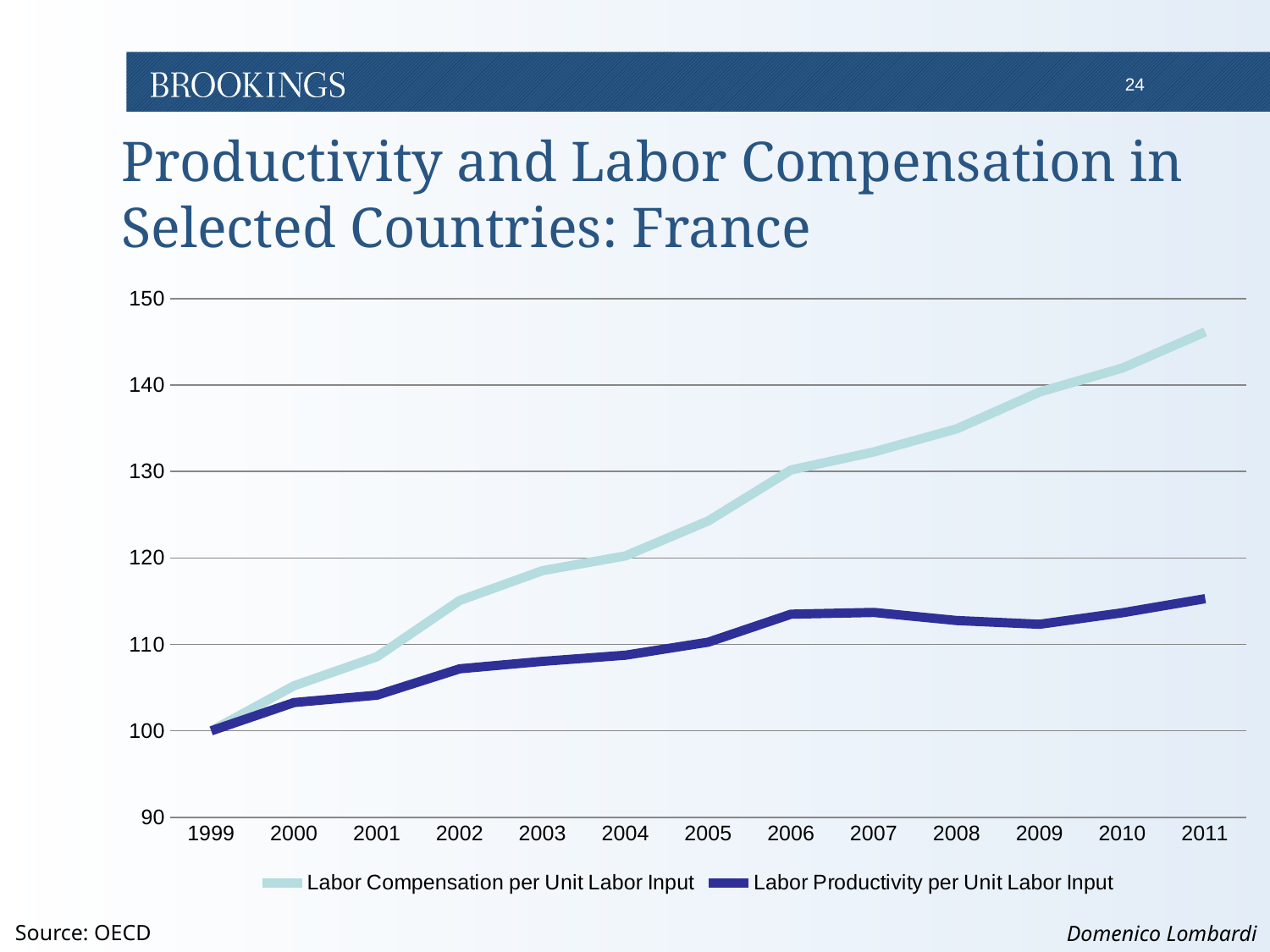
What is the value of Labor Productivity per Unit Labor Input in 1999? 100 What kind of chart is shown on the slide? line chart How many years are shown on the x axis? 13 In which year is Labor Compensation per Unit Labor Input highest? 2011 Is the value for Labor Productivity per Unit Labor Input in 2011 greater or less than 110? greater In 2011, which series has the higher value, Labor Compensation per Unit Labor Input or Labor Productivity per Unit Labor Input? Labor Compensation per Unit Labor Input What is the value of Labor Compensation per Unit Labor Input in 1999? 100 Is the value for Labor Compensation per Unit Labor Input in 2011 greater or less than 140? greater In which year is Labor Productivity per Unit Labor Input lowest? 1999 Is the value for Labor Productivity per Unit Labor Input in 2007 greater or less than 120? less How many series does the legend list? 2